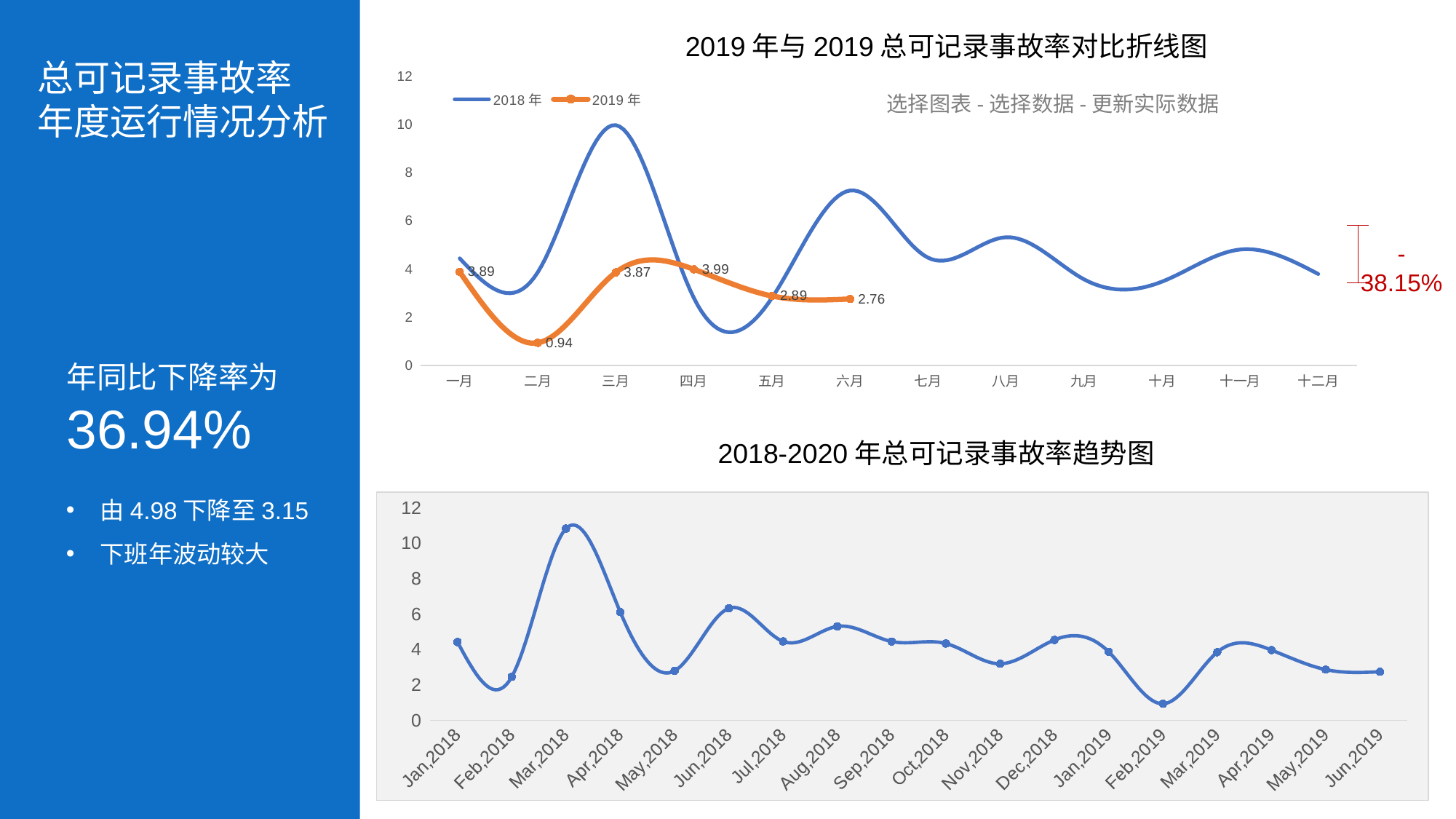
In the top chart, which month has the highest value for the 2019 年 series? 四月 How many months are shown on the x axis of the top chart? 12 In the bottom chart, is the value for Mar,2018 greater or less than 10? greater In the top chart (2019 年与 2019 总可记录事故率对比折线图), what is the value for 2019 年 in 二月? 0.94 In the top chart, what is the difference between the 2019 年 values for 四月 and 五月? 1.10 In the bottom chart, which point has the highest value? Mar,2018 In the top chart, what is the value for 2019 年 in 四月? 3.99 In the top chart, which month has the lowest value for the 2019 年 series? 二月 In the top chart, is the value for 2018 年 in 三月 greater or less than 8? greater What kind of chart is the bottom chart (2018-2020 年总可记录事故率趋势图)? line chart In the top chart, is the 2019 年 value for 一月 or 三月 larger? 一月 How many series does the legend of the top chart list? 2